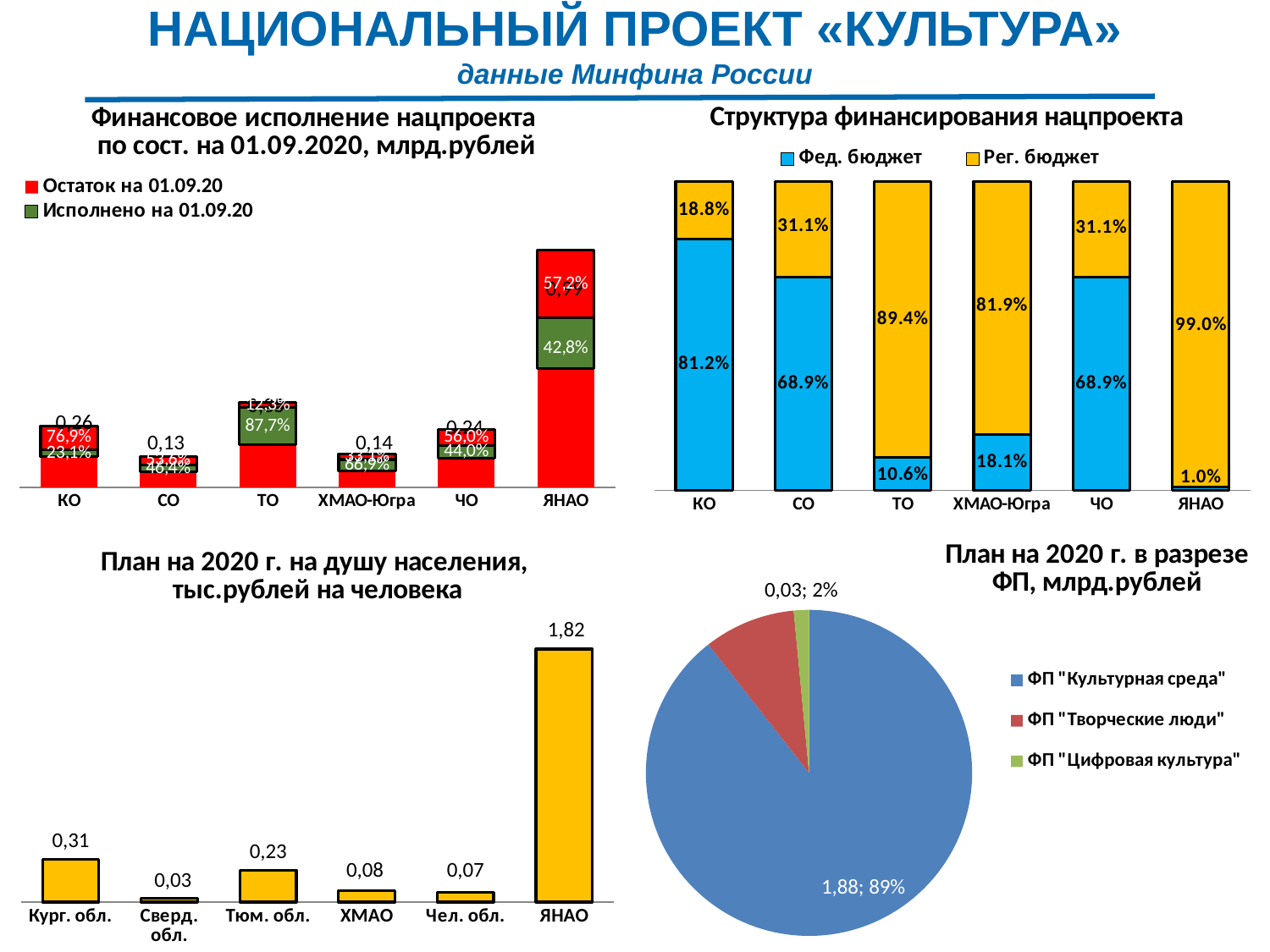
What kind of chart is 'План на 2020 г. в разрезе ФП, млрд.рублей'? pie chart In the chart 'Структура финансирования нацпроекта', what is the Рег. бюджет share for ЯНАО? 99.0% In the chart 'Финансовое исполнение нацпроекта по сост. на 01.09.2020, млрд.рублей', what is the total value labelled for ХМАО-Югра? 0,14 In the chart 'Структура финансирования нацпроекта', what is the Фед. бюджет share for КО? 81.2% In the chart 'Структура финансирования нацпроекта', how many series does the legend list? 2 In the chart 'План на 2020 г. на душу населения, тыс.рублей на человека', what is the value for Кург. обл.? 0,31 In the chart 'План на 2020 г. на душу населения, тыс.рублей на человека', which region has the lowest value? Сверд. обл. In the chart 'План на 2020 г. на душу населения, тыс.рублей на человека', which region has the highest value? ЯНАО In the chart 'Финансовое исполнение нацпроекта по сост. на 01.09.2020, млрд.рублей', what is the Исполнено на 01.09.20 percentage for ЯНАО? 42,8% In the chart 'План на 2020 г. на душу населения, тыс.рублей на человека', how many regions are shown? 6 In the chart 'Структура финансирования нацпроекта', which region has the lowest Фед. бюджет share? ЯНАО In the chart 'План на 2020 г. в разрезе ФП, млрд.рублей', what share of the pie is ФП "Культурная среда"? 89%